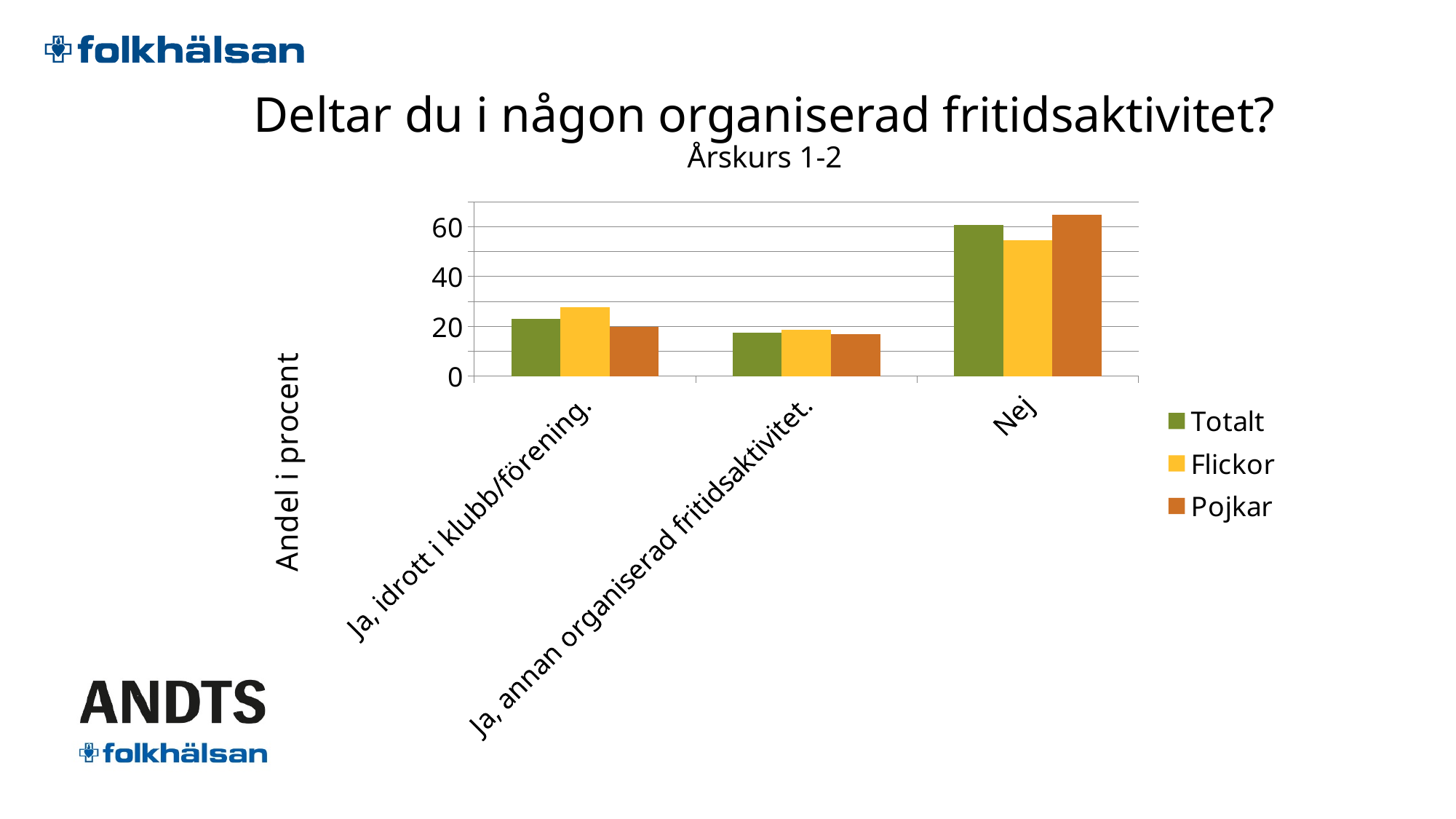
Which series is shown in green in the legend? Totalt Is the Flickor value for Nej greater or less than 60? less What kind of chart is shown on the slide? bar chart Is the Pojkar value for Nej greater or less than 60? greater How many categories are shown on the x axis of the chart? 3 Which category has the highest value for the Totalt series? Nej For the Nej category, which is larger: Flickor or Pojkar? Pojkar For the category 'Ja, idrott i klubb/förening.', which is larger: Flickor or Pojkar? Flickor How many series does the legend list? 3 Is the Flickor value for 'Ja, idrott i klubb/förening.' greater or less than 20? greater What is the label of the y axis? Andel i procent Which category has the lowest value for the Pojkar series? Ja, annan organiserad fritidsaktivitet.